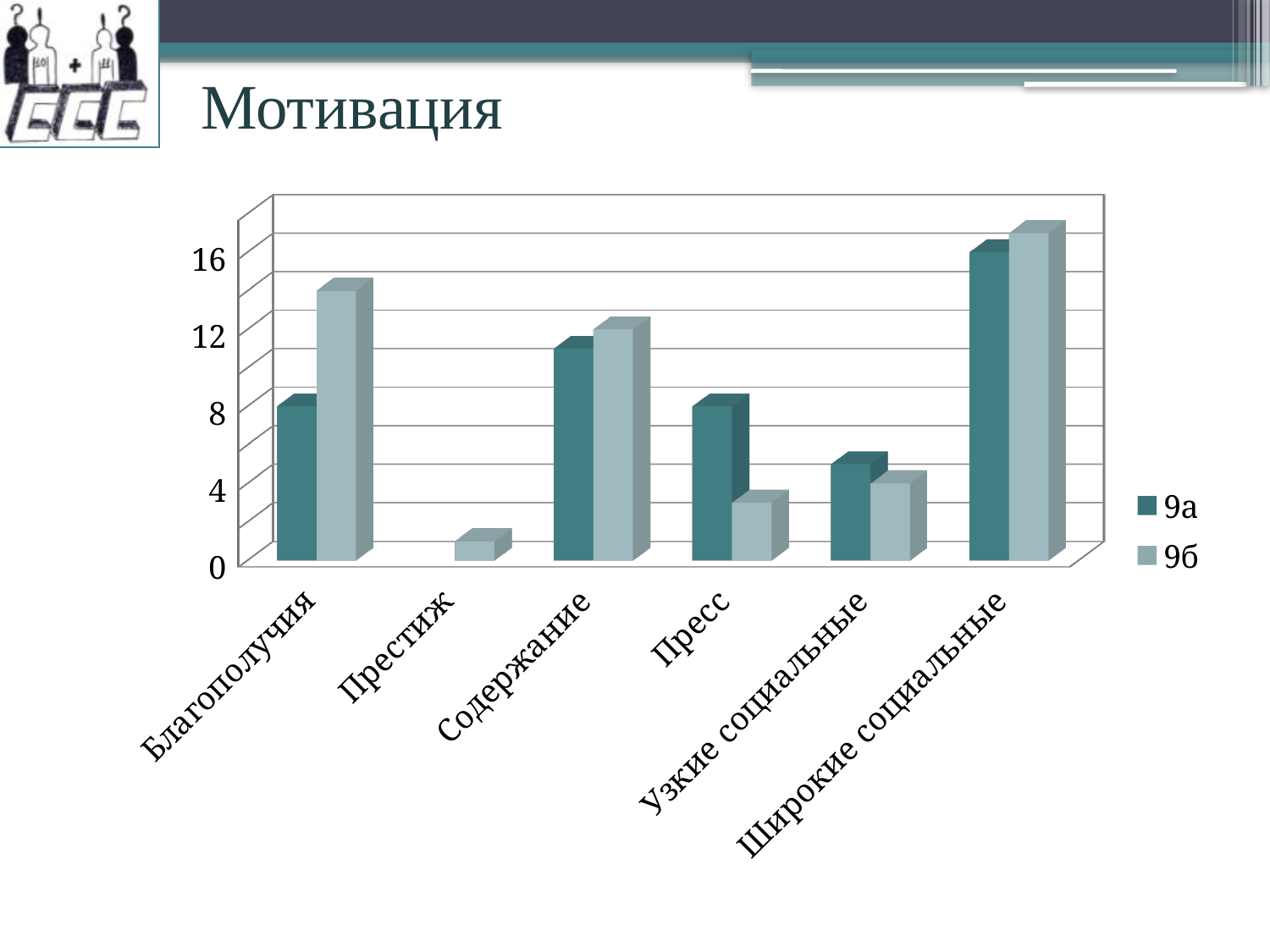
Which category has the lowest value for series 9б? Престиж What is the title of the slide containing the chart? Мотивация What kind of chart is shown on the slide? Bar chart Is the value for 9б in the category Благополучия greater or less than 12? greater How many categories are shown on the x axis? 6 Which category has the highest value for series 9б? Широкие социальные Is the value for 9б in the category Пресс greater or less than 4? less For the category Благополучия, which series has the larger value, 9а or 9б? 9б What are the two entries listed in the chart legend? 9а and 9б Which category has the highest value for series 9а? Широкие социальные For the category Пресс, which series has the larger value, 9а or 9б? 9а How many series does the legend list? 2